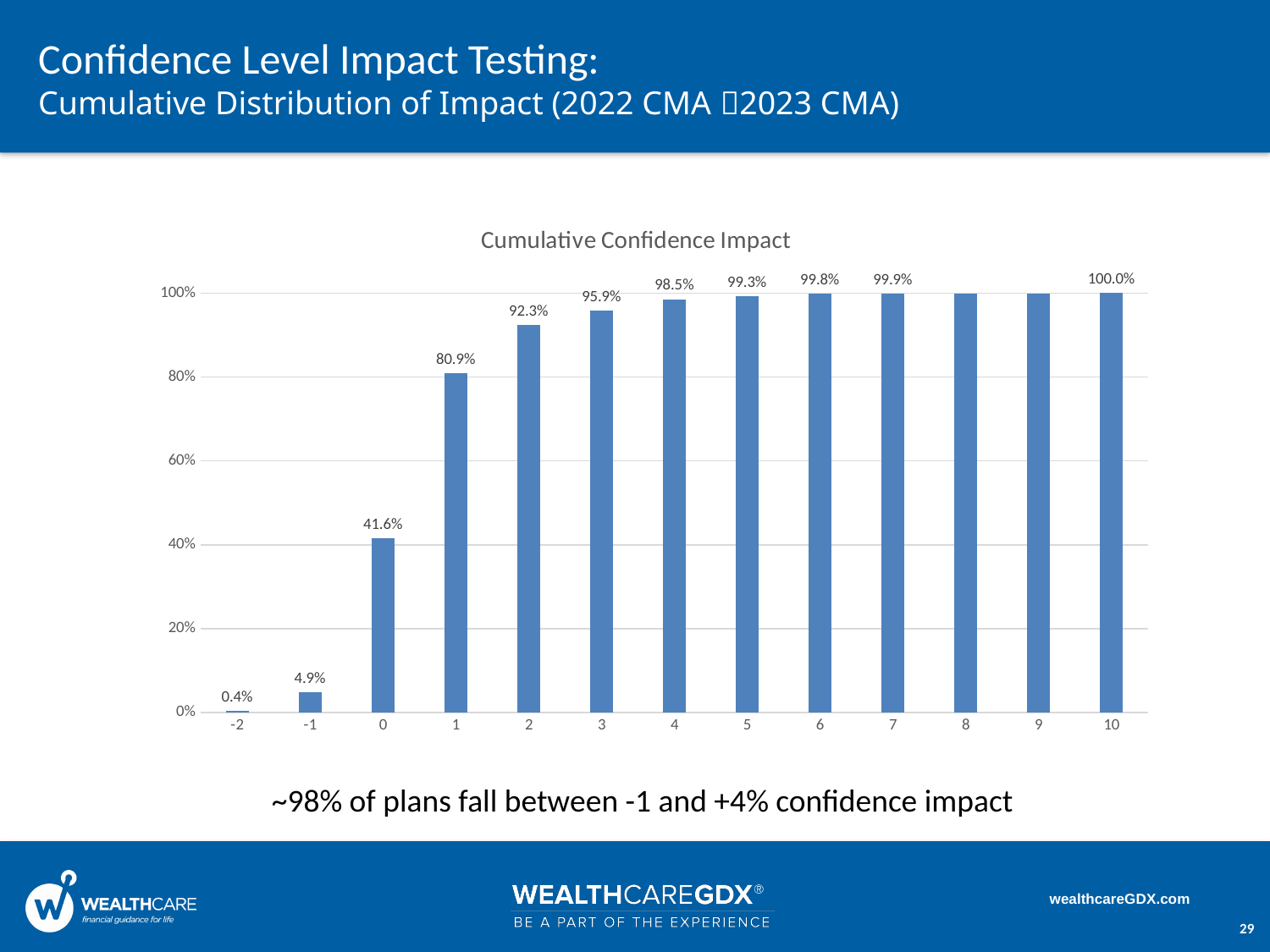
Which category has the lowest value in the Cumulative Confidence Impact chart? -2 Is the value for category 8 in the Cumulative Confidence Impact chart greater or less than 80%? greater What is the difference between the values for categories 1 and 0 in the Cumulative Confidence Impact chart? 39.3 percentage points What is the value for category -1 in the Cumulative Confidence Impact chart? 4.9% What kind of chart is the Cumulative Confidence Impact chart? bar chart What is the value for category 1 in the Cumulative Confidence Impact chart? 80.9% What is the value for category 3 in the Cumulative Confidence Impact chart? 95.9% Do the values in the Cumulative Confidence Impact chart rise or fall from left to right along the x axis? rise What is the difference between the values for categories 2 and 1 in the Cumulative Confidence Impact chart? 11.4 percentage points What is the value for category 0 in the Cumulative Confidence Impact chart? 41.6% Which is larger in the Cumulative Confidence Impact chart, the value for category 0 or the value for category 1? category 1 How many categories are shown on the x axis of the Cumulative Confidence Impact chart? 13